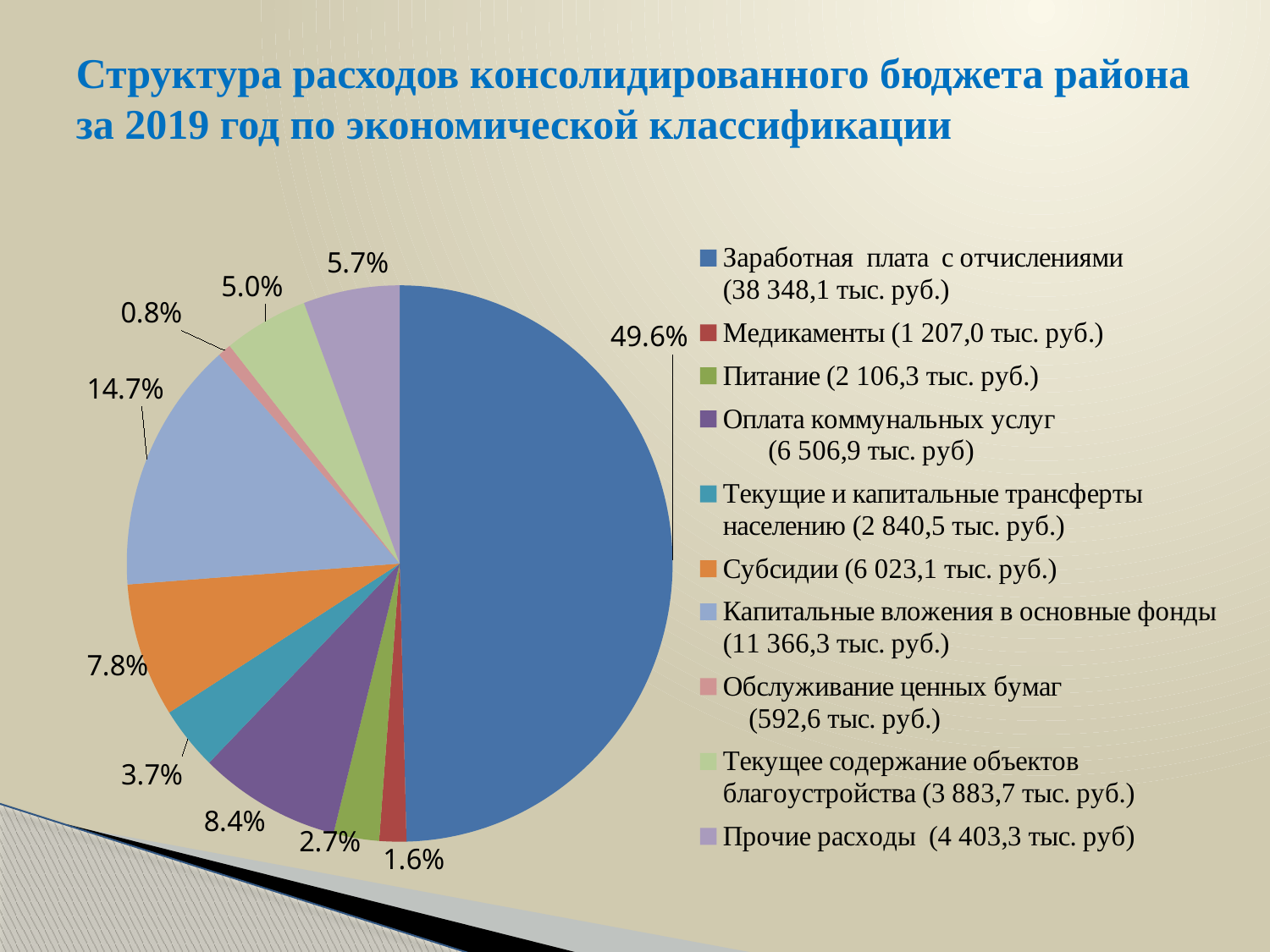
Which category has the smallest slice of the pie? Обслуживание ценных бумаг What share of the pie does "Субсидии" take? 7.8% What share of the pie does "Капитальные вложения в основные фонды" take? 14.7% Which slice is larger: "Прочие расходы" or "Текущее содержание объектов благоустройства"? Прочие расходы What is the title of the chart on the slide? Структура расходов консолидированного бюджета района за 2019 год по экономической классификации Which category has the largest slice of the pie? Заработная плата с отчислениями What is the difference in percentage points between the "Оплата коммунальных услуг" slice (8.4%) and the "Субсидии" slice (7.8%)? 0.6 What share of the pie does "Обслуживание ценных бумаг" take? 0.8% What kind of chart is shown on the slide? pie chart How many slices does the pie chart have? 10 What amount in thousand rubles does the legend give for "Медикаменты"? 1 207,0 тыс. руб.